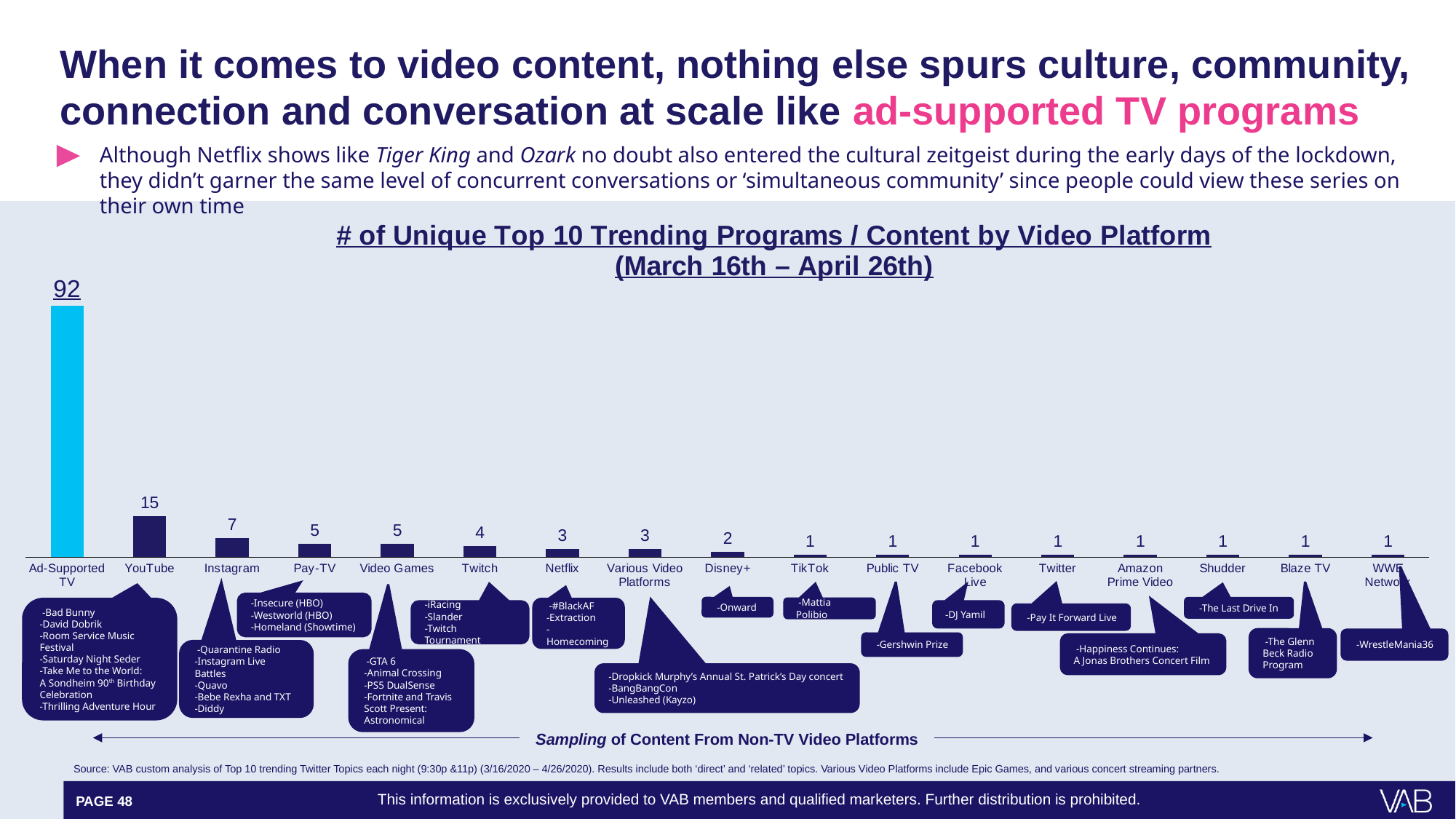
What colour is the bar for Ad-Supported TV? Light blue What is the value for Instagram? 7 Do the values rise or fall moving from left to right along the x axis? Fall What is the value for Disney+? 2 Which has a larger value, Twitch or Pay-TV? Pay-TV What is the value for Ad-Supported TV? 92 Which platform has the highest number of unique top 10 trending programs? Ad-Supported TV How many platforms (categories) are shown on the x axis? 17 What kind of chart is shown on the slide? Bar chart What is the value for Netflix? 3 What is the value for YouTube? 15 What is the difference between the values for Ad-Supported TV and YouTube? 77